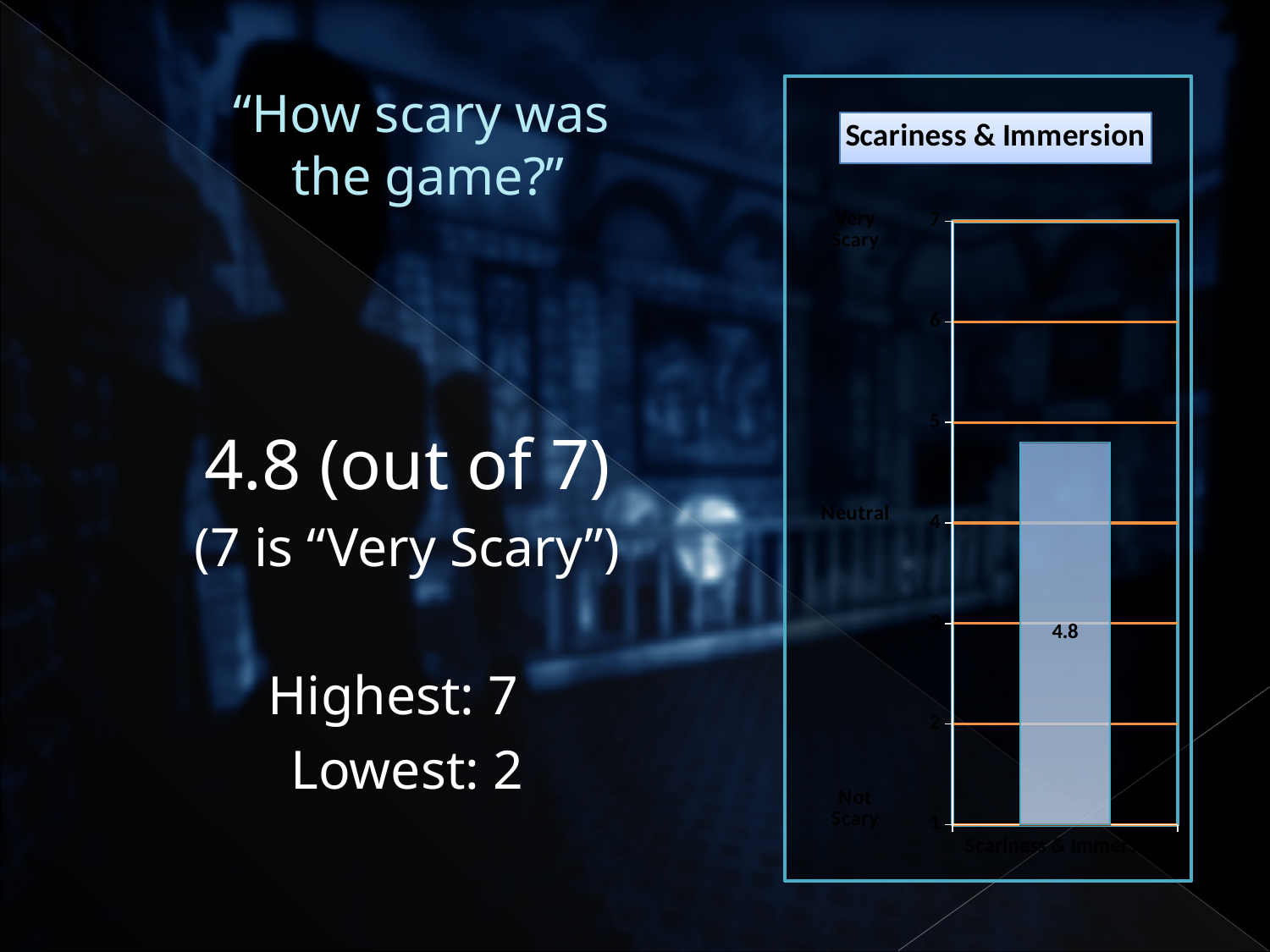
Is the value of the bar in the "Scariness & Immersion" chart greater or less than 7? less What kind of chart is shown on the slide? bar chart What is the highest value shown on the y axis of the "Scariness & Immersion" chart? 7 What is the value of the bar in the "Scariness & Immersion" chart? 4.8 Is the value of the bar in the "Scariness & Immersion" chart greater or less than 5? less How many bars are plotted in the "Scariness & Immersion" chart? 1 What is the title of the chart on the slide? Scariness & Immersion Is the value of the bar in the "Scariness & Immersion" chart greater or less than 4? greater